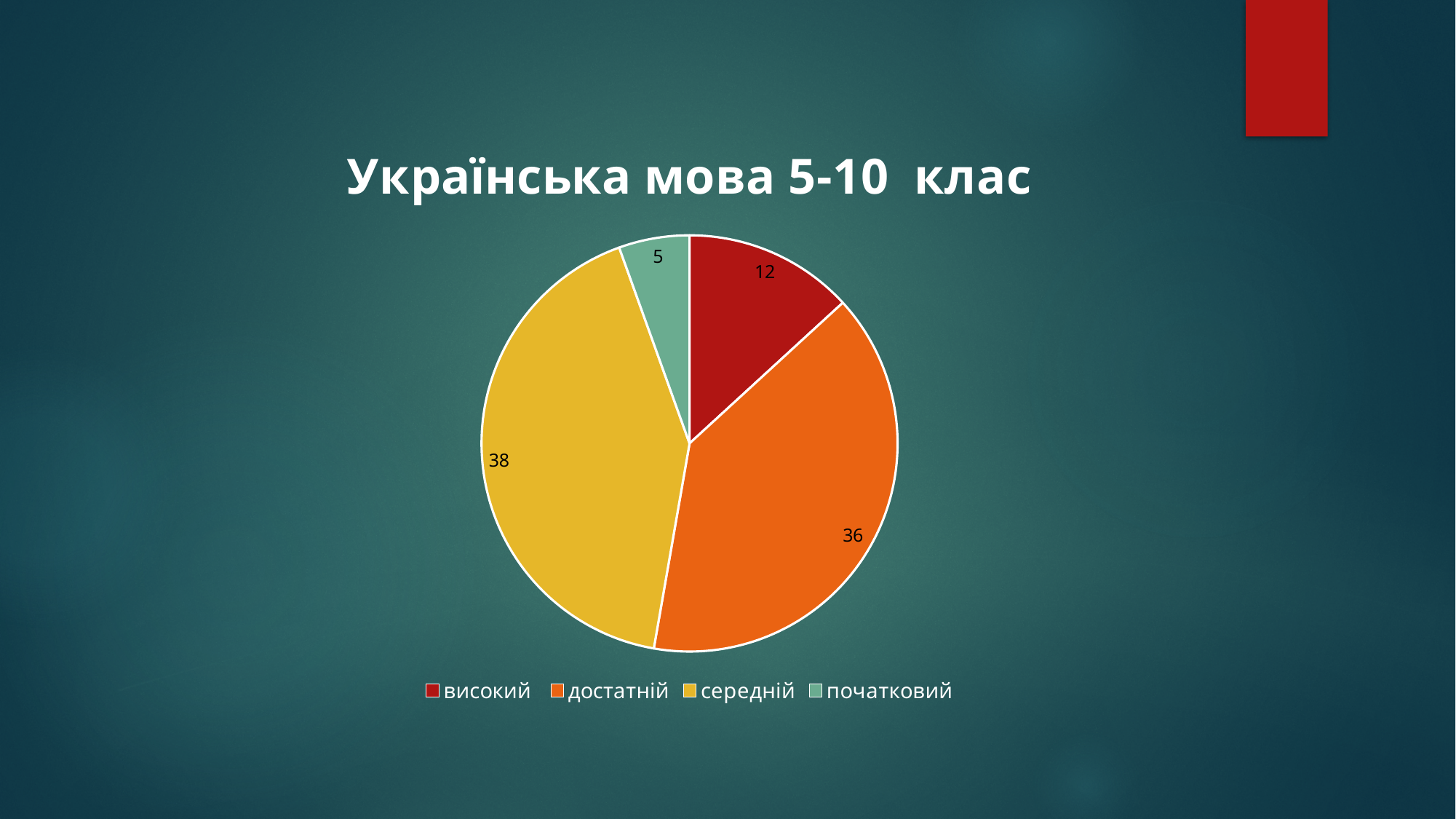
What type of chart is shown on the slide? pie chart What is the difference between the values for "середній" and "достатній"? 2 Which is larger, the value for "високий" or the value for "початковий"? високий How many categories does the legend list? 4 What is the difference between the values for "високий" and "початковий"? 7 Which category has the largest slice? середній Which category has the smallest slice? початковий What is the title of the chart? Українська мова 5-10 клас What is the value for the "початковий" slice? 5 What is the value for the "достатній" slice? 36 What is the value for the "середній" slice? 38 What is the value for the "високий" slice? 12